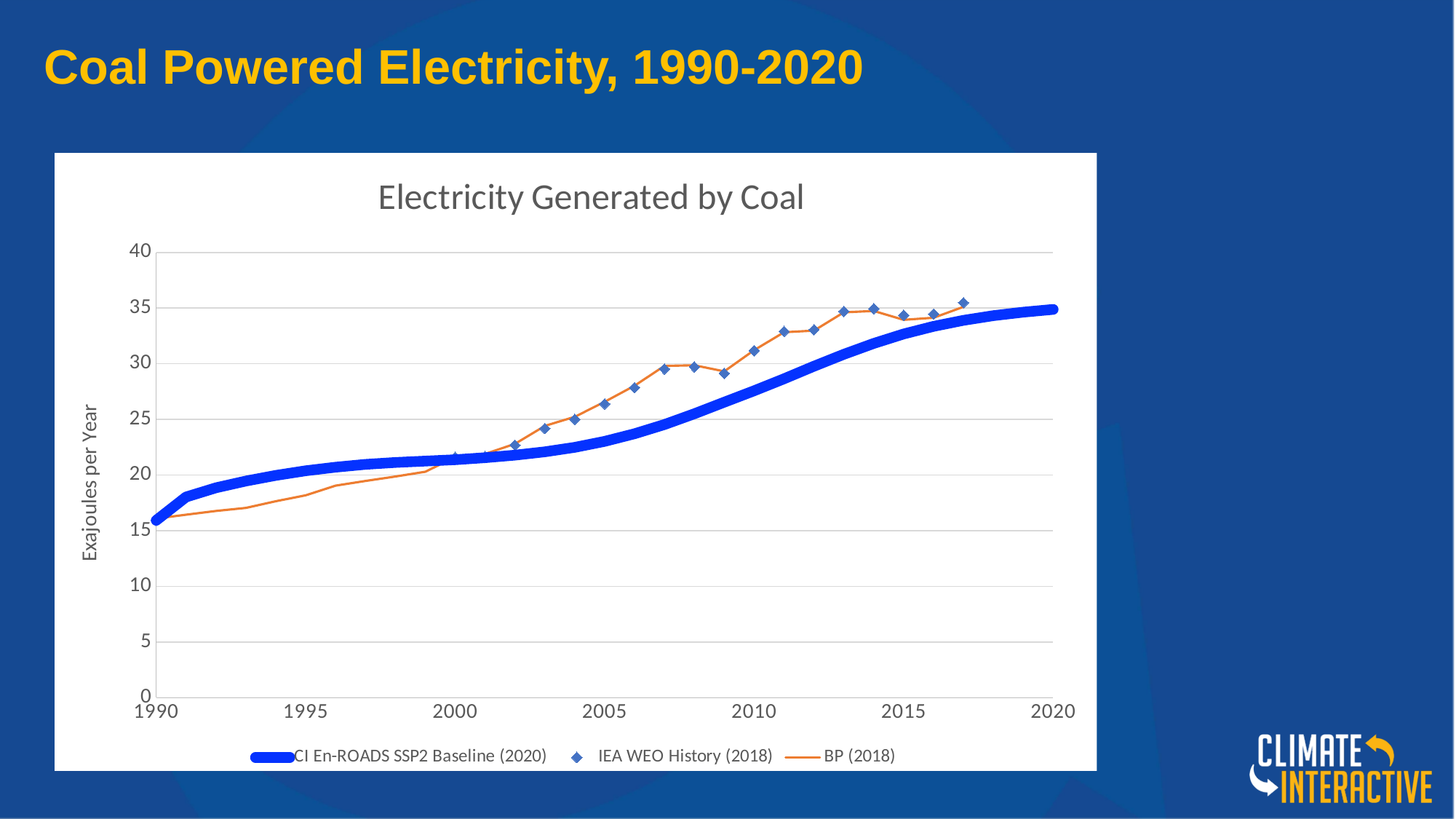
What is the label on the y axis of the chart? Exajoules per Year Is the value for IEA WEO History (2018) in 2013 greater or less than 30? greater Is the value for BP (2018) in 2000 greater or less than 25? less Is the value for IEA WEO History (2018) in 2017 greater or less than 30? greater In 1995, which series has the higher value: CI En-ROADS SSP2 Baseline (2020) or BP (2018)? CI En-ROADS SSP2 Baseline (2020) How many series does the legend list? 3 Does the CI En-ROADS SSP2 Baseline (2020) series rise or fall from 1990 to 2020? rise In 2007, which series has the higher value: IEA WEO History (2018) or CI En-ROADS SSP2 Baseline (2020)? IEA WEO History (2018) What is the title of the chart? Electricity Generated by Coal What kind of chart is shown on the slide? line chart